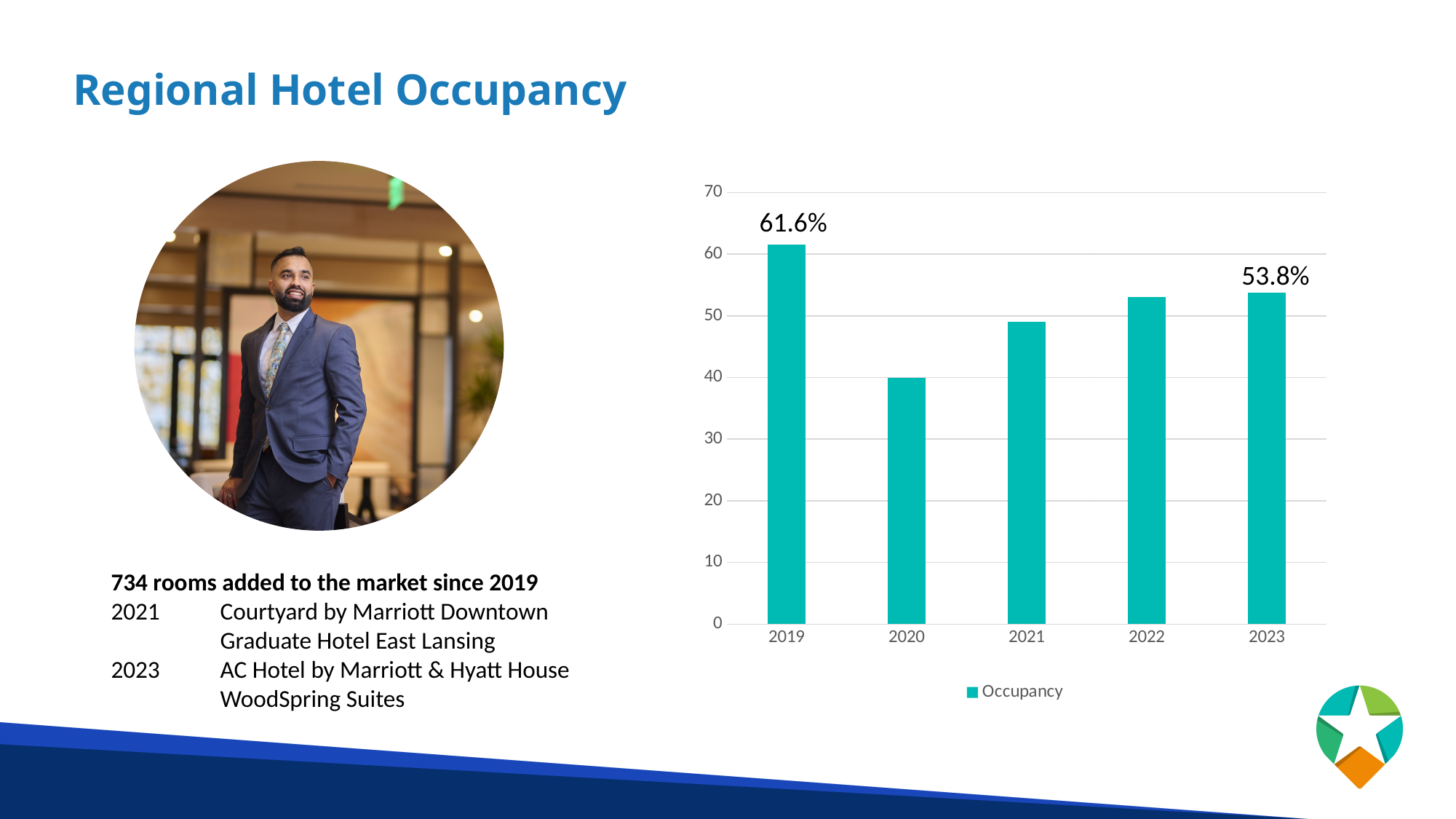
How many series does the chart legend list? 1 Is the occupancy value for 2020 greater or less than 50? less Which year has the highest occupancy bar? 2019 Is the occupancy value for 2022 greater or less than 50? greater What is the occupancy value shown for 2019? 61.6% Which year has the lowest occupancy bar? 2020 What kind of chart is used to show regional hotel occupancy? Bar chart Which year has the larger occupancy, 2019 or 2023? 2019 Is the occupancy value for 2021 greater or less than 40? greater How many years are shown on the x axis of the chart? 5 By how many percentage points does the 2019 occupancy exceed the 2023 occupancy? 7.8 percentage points What is the occupancy value shown for 2023? 53.8%